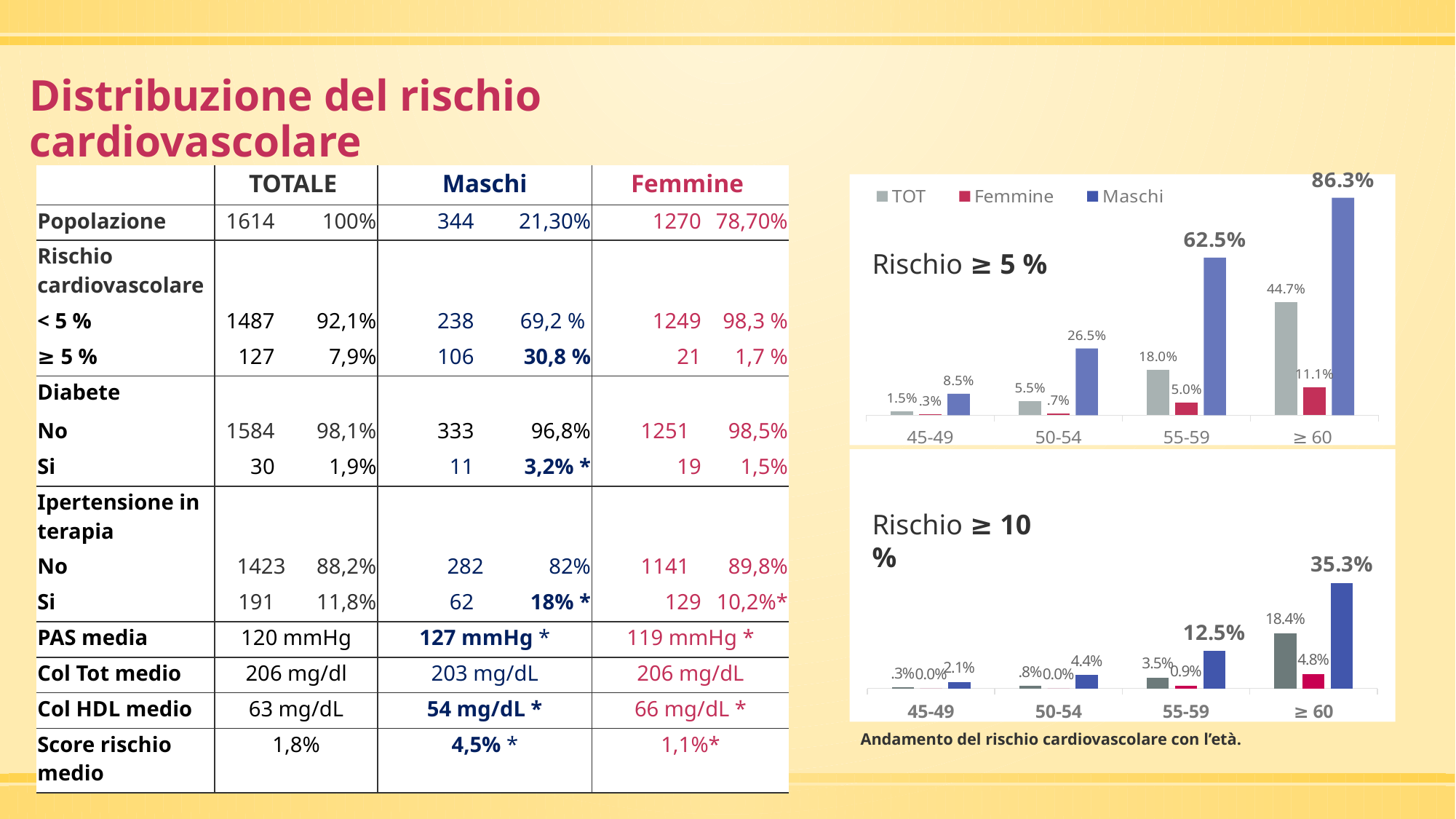
In the 'Rischio ≥ 10 %' chart, what is the difference between the Maschi and TOT values in the ≥ 60 age group? 16.9% In the 'Rischio ≥ 5 %' chart, do the Maschi values rise or fall as age increases along the x axis? rise In the 'Rischio ≥ 5 %' chart, what is the value for TOT in the 55-59 age group? 18.0% In the 'Rischio ≥ 5 %' chart, which is larger in the 50-54 age group: the Maschi value or the TOT value? Maschi How many series does the legend of the 'Rischio ≥ 5 %' chart list? 3 In the 'Rischio ≥ 10 %' chart, what is the value for Maschi in the ≥ 60 age group? 35.3% In the 'Rischio ≥ 5 %' chart, what is the difference between the Maschi and Femmine values in the 55-59 age group? 57.5% How many age groups are shown on the x axis of the 'Rischio ≥ 10 %' chart? 4 In the 'Rischio ≥ 10 %' chart, what is the value for Femmine in the 55-59 age group? 0.9% In the 'Rischio ≥ 10 %' chart, which age group has the lowest value for TOT? 45-49 In the 'Rischio ≥ 5 %' chart, what is the value for Maschi in the ≥ 60 age group? 86.3% In the 'Rischio ≥ 5 %' chart, which age group has the highest value for Maschi? ≥ 60